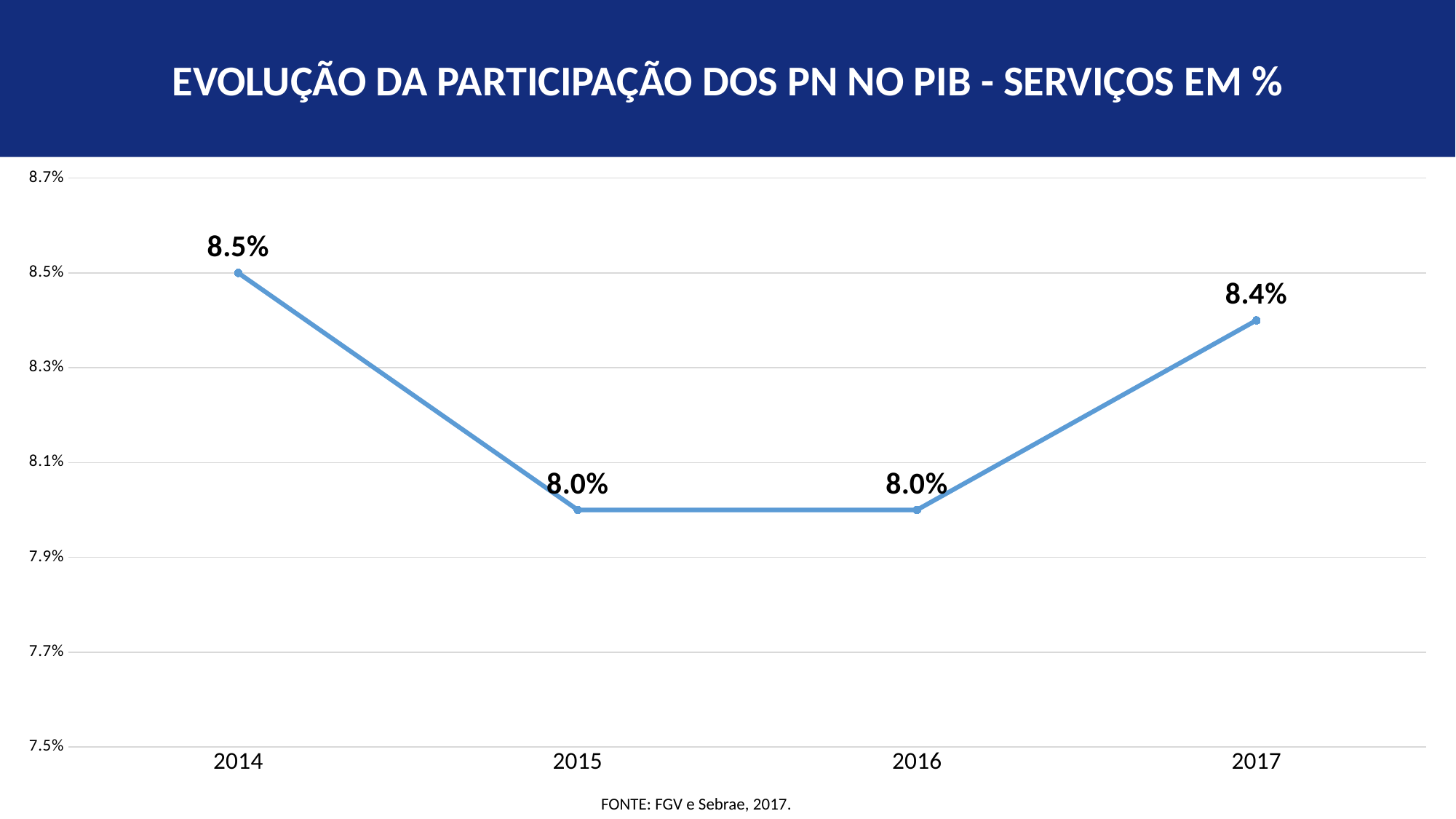
What is the title of the chart? EVOLUÇÃO DA PARTICIPAÇÃO DOS PN NO PIB - SERVIÇOS EM % Does the value rise or fall from 2014 to 2015? fall What is the value for 2017? 8.4% Which year has the highest value? 2014 What is the value for 2014? 8.5% What is the difference between the values for 2014 and 2015? 0.5% What is the value for 2015? 8.0% Is the value for 2016 greater or less than 8.1%? less Which is larger, the value for 2014 or the value for 2017? 2014 How many years are plotted on the chart? 4 What is the difference between the values for 2017 and 2016? 0.4% What kind of chart is shown on the slide? line chart